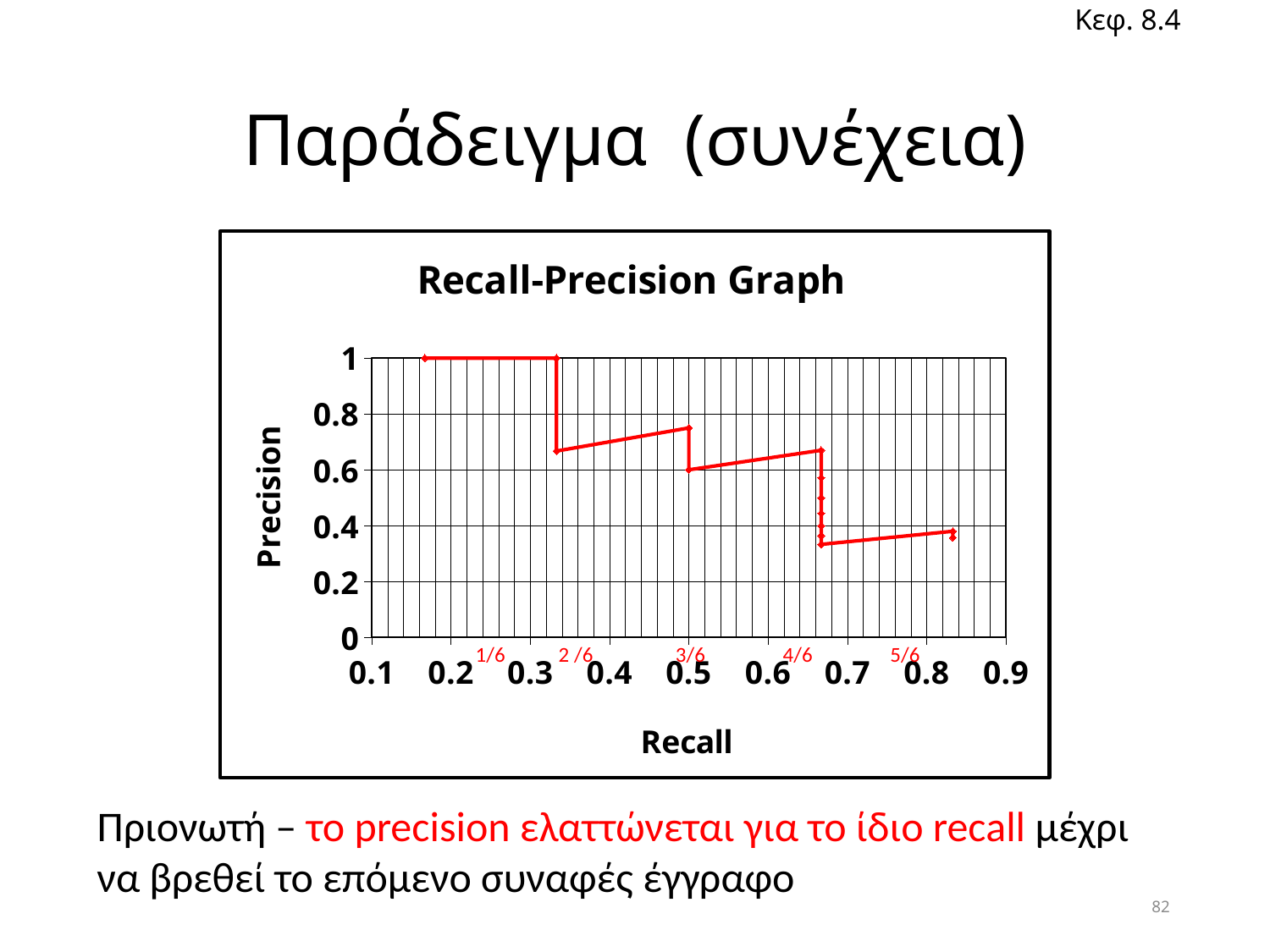
What is the title of the chart? Recall-Precision Graph Which is larger: the precision at recall 1/6 or the precision at recall 5/6? recall 1/6 Which recall level has the highest precision value? 1/6 and 2/6 (both at precision 1) What kind of chart is shown on the slide? line chart What is the label of the vertical axis of the chart? Precision What is the precision value at the first plotted point (recall 1/6)? 1 What is the highest value shown on the Precision axis? 1 Is the lowest precision value plotted at recall 2/6 greater or less than 0.8? less Is the lowest precision value plotted at recall 4/6 greater or less than 0.4? less Is the highest precision value plotted at recall 3/6 greater or less than 0.6? greater Overall, does precision rise or fall as recall increases along the x axis? fall